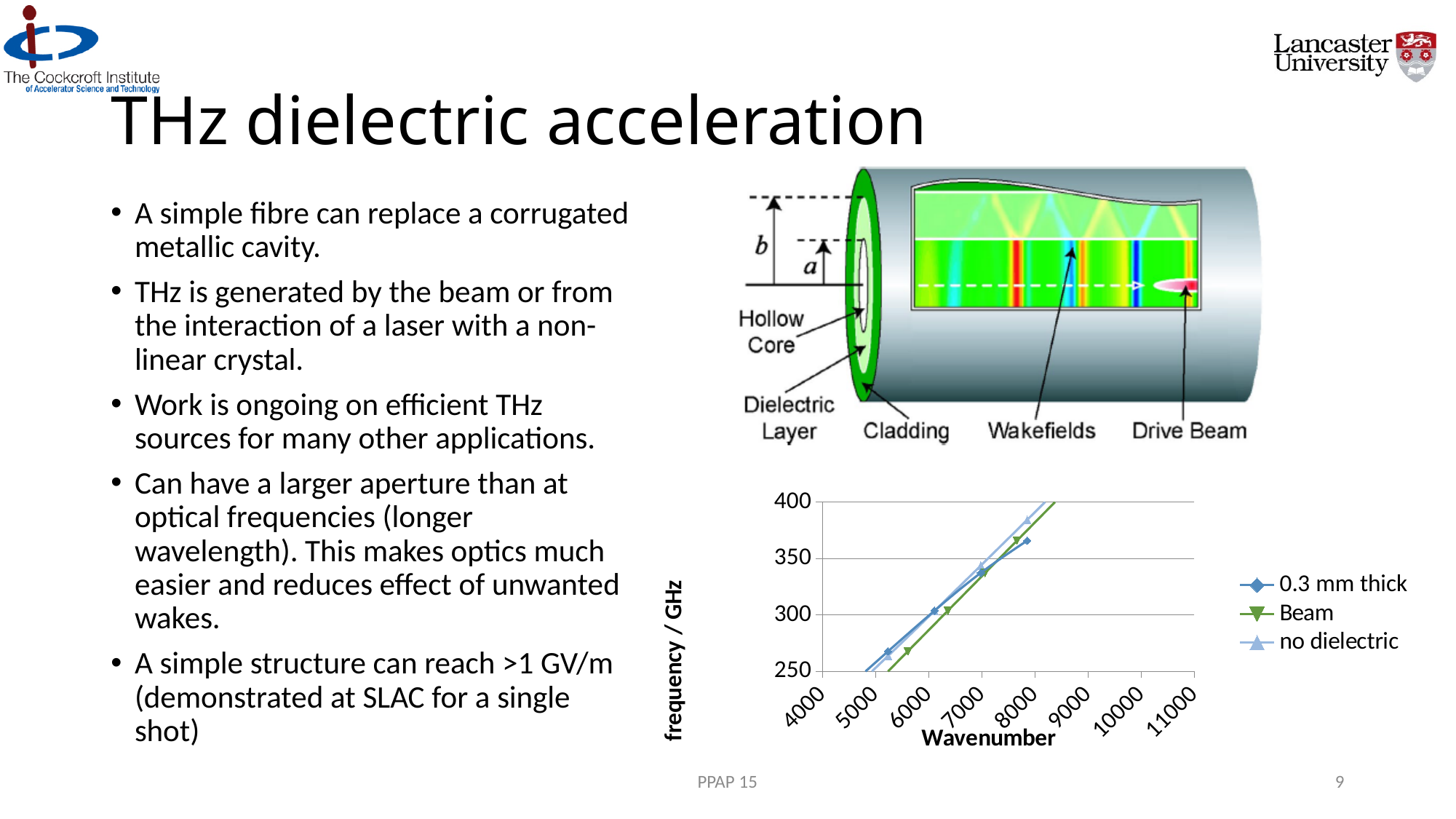
Is the value for the 0.3 mm thick series at wavenumber 5000 greater or less than 300? less What is the highest value shown on the chart's y axis? 400 Is the value for the 0.3 mm thick series at wavenumber 8000 greater or less than 350? greater What are the three series named in the chart legend? 0.3 mm thick, Beam, no dielectric What kind of chart is shown on the slide? line chart How many series does the chart legend list? 3 How many tick labels are shown on the chart's x axis? 8 What is the label of the chart's y axis? frequency / GHz Is the value for the no dielectric series at wavenumber 8000 greater or less than 350? greater Do the plotted frequency values rise or fall as wavenumber increases? rise